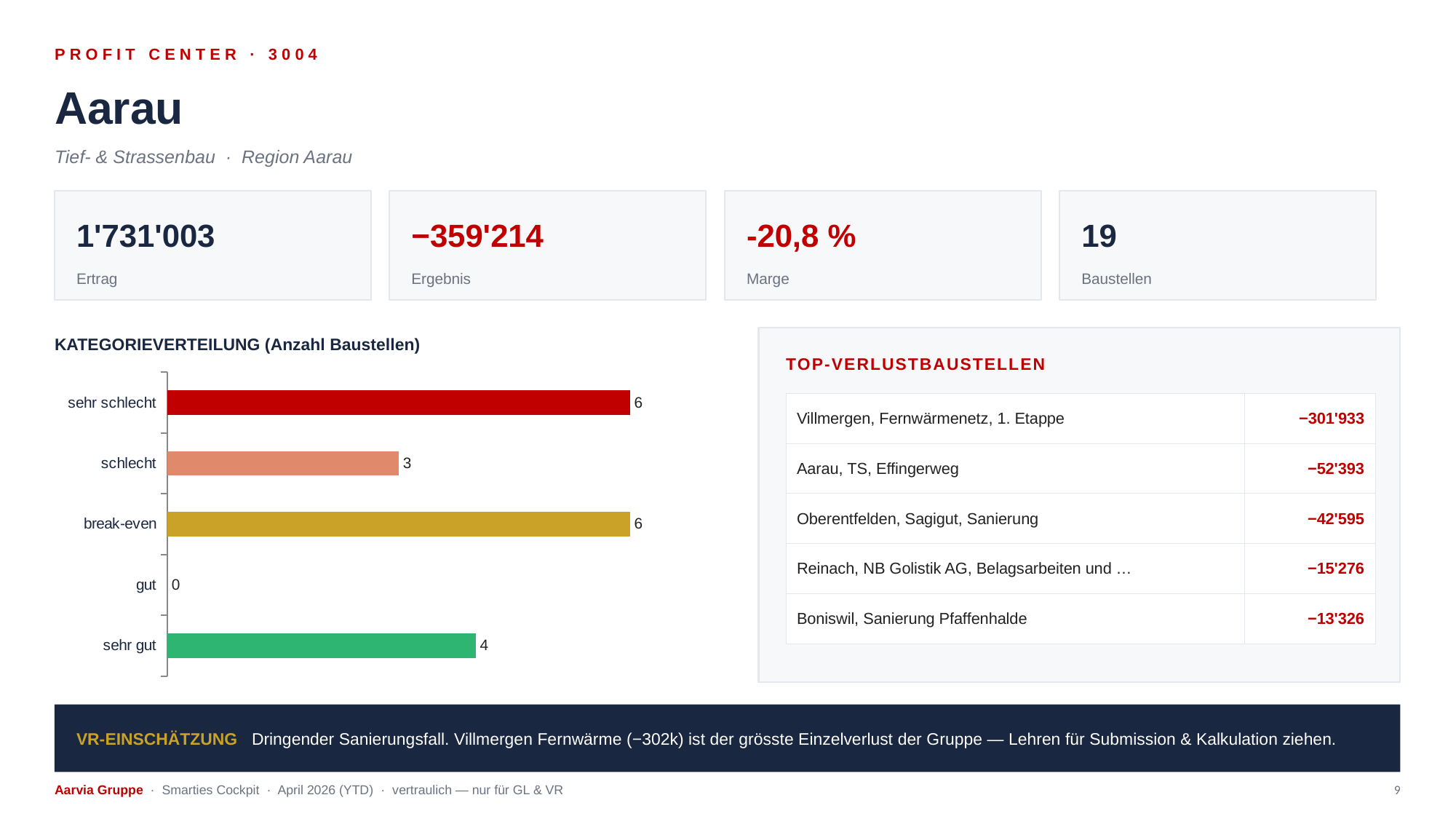
In the KATEGORIEVERTEILUNG chart, which is larger: the value for "sehr gut" or the value for "schlecht"? sehr gut How many categories are shown in the KATEGORIEVERTEILUNG chart? 5 What is the value for "gut" in the KATEGORIEVERTEILUNG chart? 0 In the KATEGORIEVERTEILUNG chart, which is larger: the value for "break-even" or the value for "sehr gut"? break-even What is the value for "schlecht" in the KATEGORIEVERTEILUNG chart? 3 How many Baustellen are shown for "sehr gut" in the KATEGORIEVERTEILUNG chart? 4 Which category has the lowest value in the KATEGORIEVERTEILUNG chart? gut What is the difference between the values for "sehr gut" and "schlecht" in the KATEGORIEVERTEILUNG chart? 1 What is the title of the chart on the slide? KATEGORIEVERTEILUNG (Anzahl Baustellen) What kind of chart is the KATEGORIEVERTEILUNG chart? bar chart What is the difference between the values for "sehr schlecht" and "schlecht" in the KATEGORIEVERTEILUNG chart? 3 What is the value for "break-even" in the KATEGORIEVERTEILUNG chart? 6